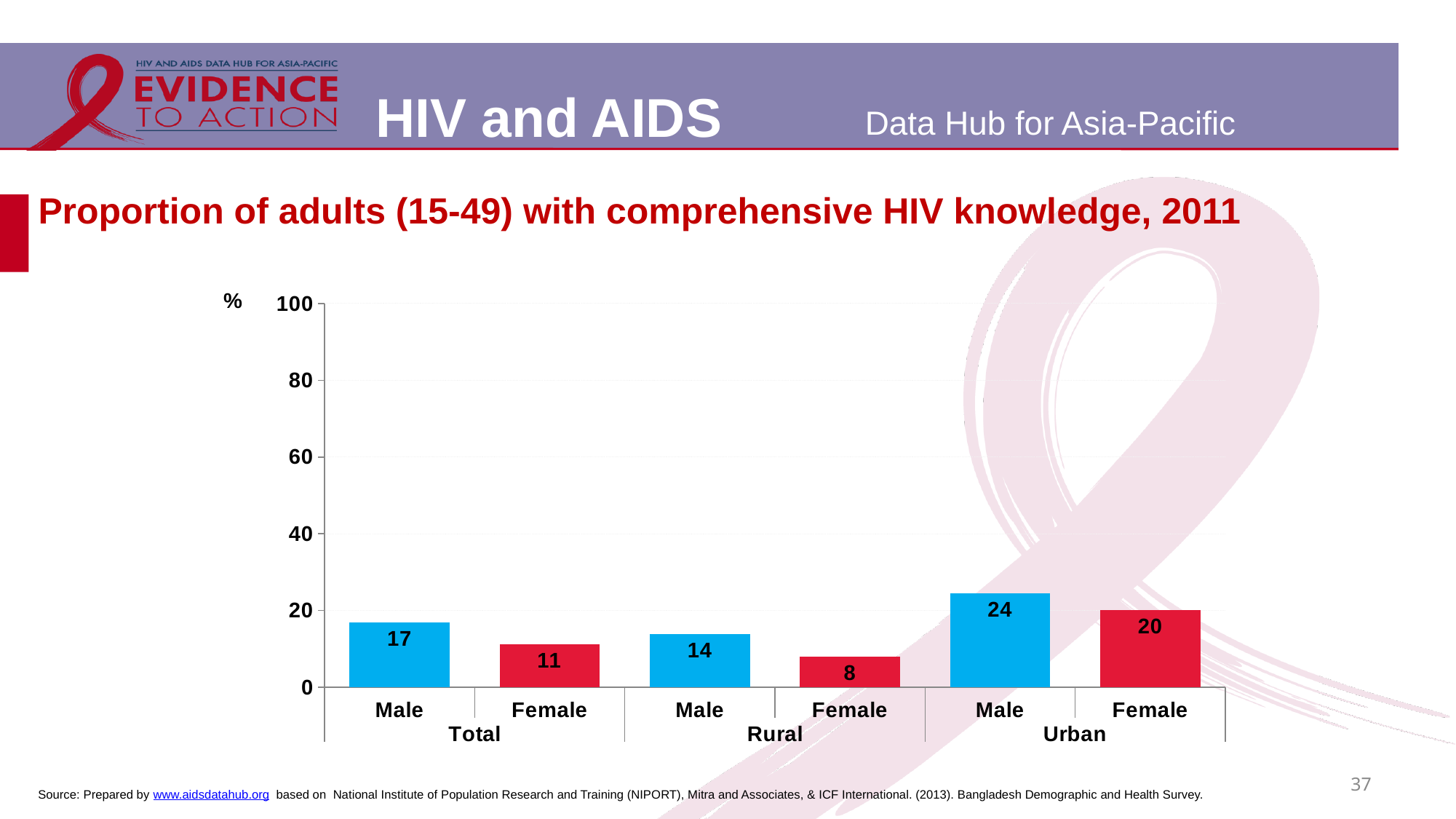
What kind of chart is shown on the slide? bar chart What is the value for Total Female? 11 Which bar has the lowest value? Rural Female What is the value for Urban Male? 24 Which bar has the highest value? Urban Male What is the difference between the Total Male and Total Female values? 6 What is the value for Rural Female? 8 How many bars are plotted in the chart? 6 Is the value for Urban Male greater or less than 20? greater What is the difference between the Urban Male and Urban Female values? 4 What is the title of the chart? Proportion of adults (15-49) with comprehensive HIV knowledge, 2011 Which is larger, the Rural Male value or the Urban Female value? Urban Female